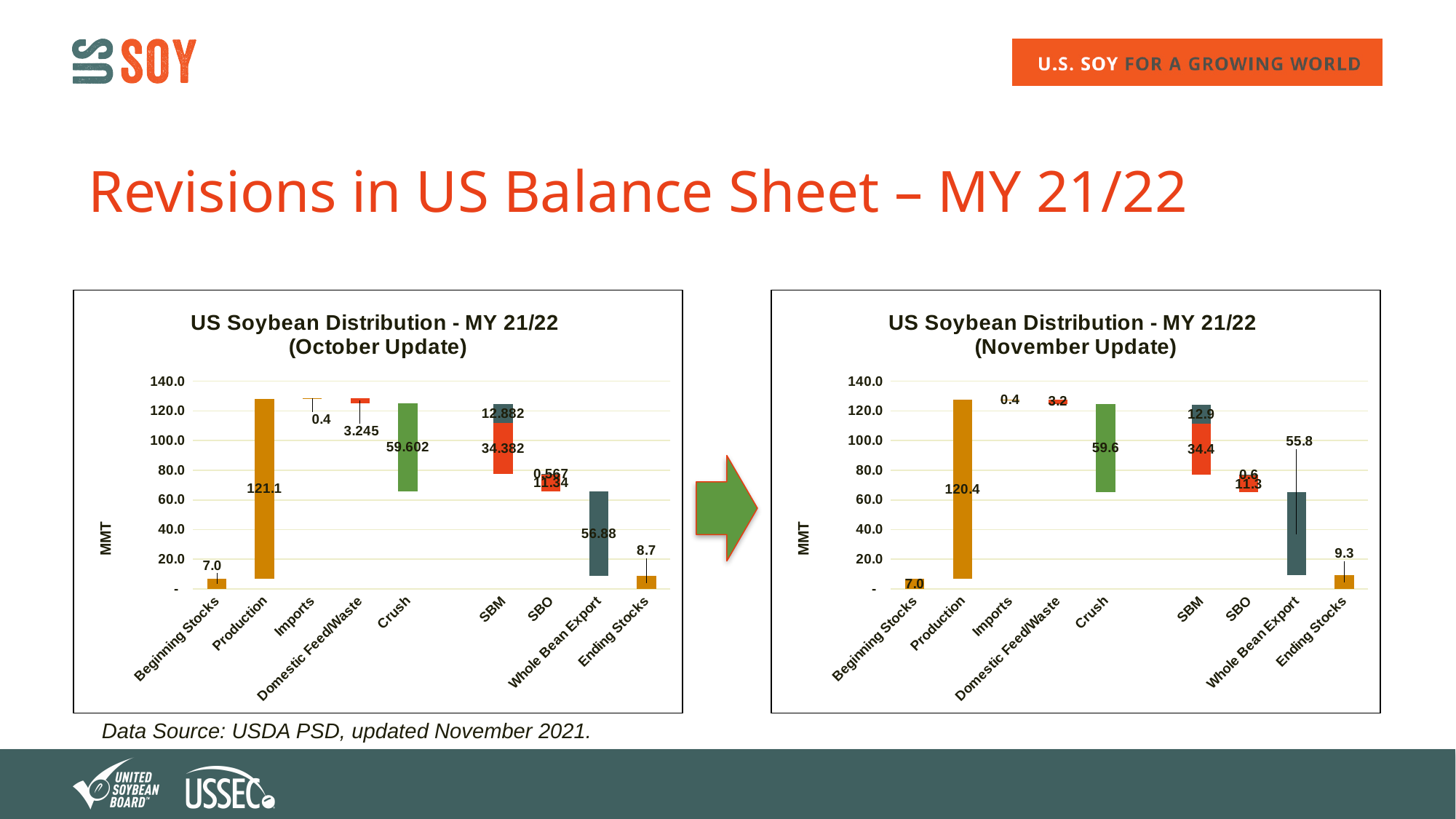
By how much did the Production value change from the October Update chart to the November Update chart? 0.7 What unit is shown on the y axis of the October Update chart? MMT In the November Update chart, what is the value for Production? 120.4 In the November Update chart, what is the value for Ending Stocks? 9.3 In the October Update chart, what is the value for Crush? 59.602 How many categories are shown on the x axis of the November Update chart? 9 In the November Update chart, what is the value for Whole Bean Export? 55.8 In the October Update chart, what is the value for Production? 121.1 What is the difference between Ending Stocks in the November Update chart and in the October Update chart? 0.6 In the October Update chart, which is larger: Crush or Whole Bean Export? Crush In the October Update chart, which category has the highest value? Production In the November Update chart, which category has the lowest labelled value? Imports